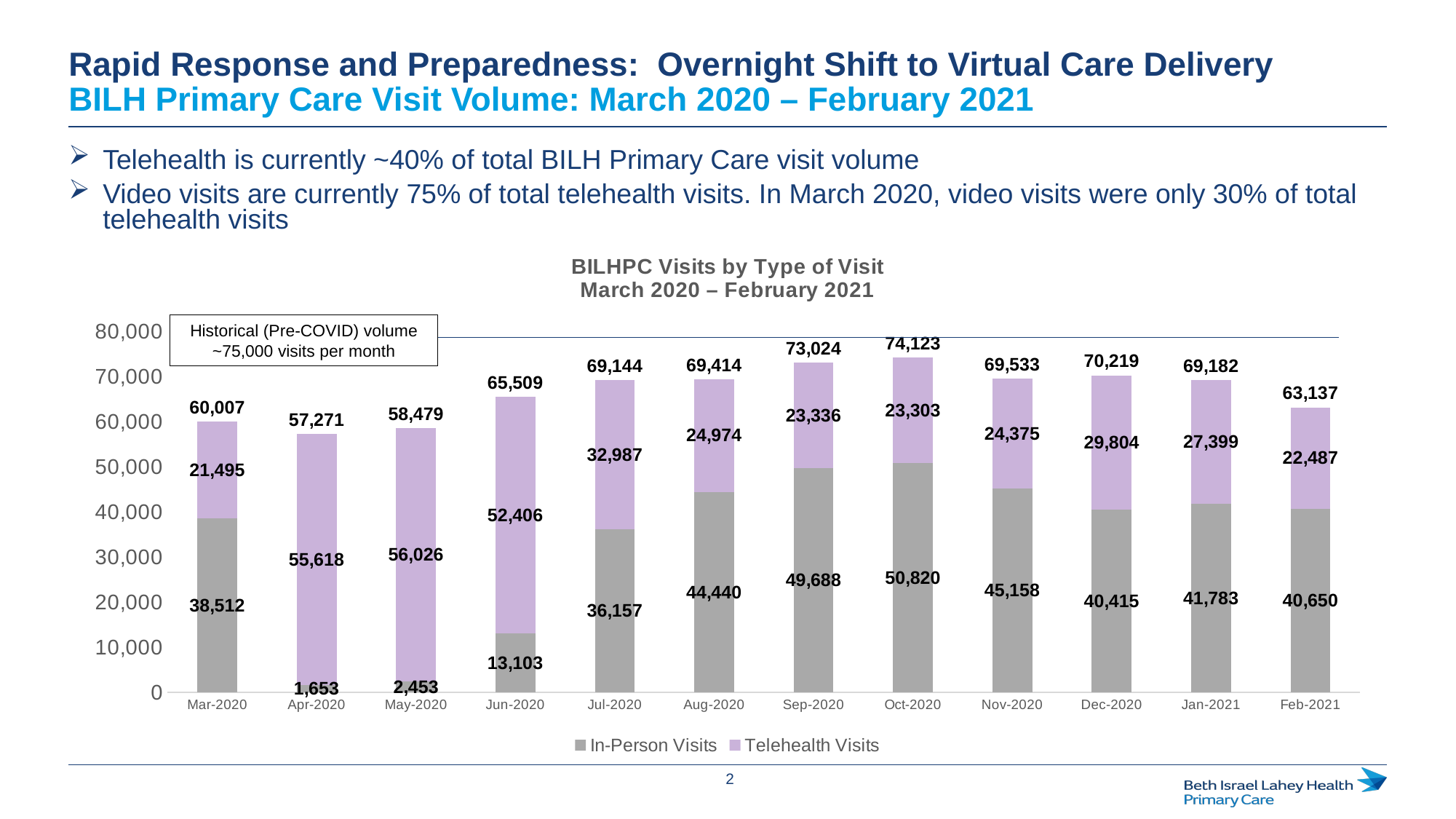
What is the number of In-Person Visits in Apr-2020? 1,653 Which month has the highest number of Telehealth Visits? May-2020 What is the number of Telehealth Visits in Jul-2020? 32,987 What type of chart is shown on the slide? Stacked bar chart Which month has the highest total visit volume? Oct-2020 In Jun-2020, which is larger: In-Person Visits or Telehealth Visits? Telehealth Visits How many series does the legend list? 2 What is the difference between In-Person Visits and Telehealth Visits in Oct-2020? 27,517 Which month has the lowest number of In-Person Visits? Apr-2020 How many months are shown on the x axis? 12 What is the title of the chart? BILHPC Visits by Type of Visit March 2020 – February 2021 What is the total number of visits in Oct-2020? 74,123